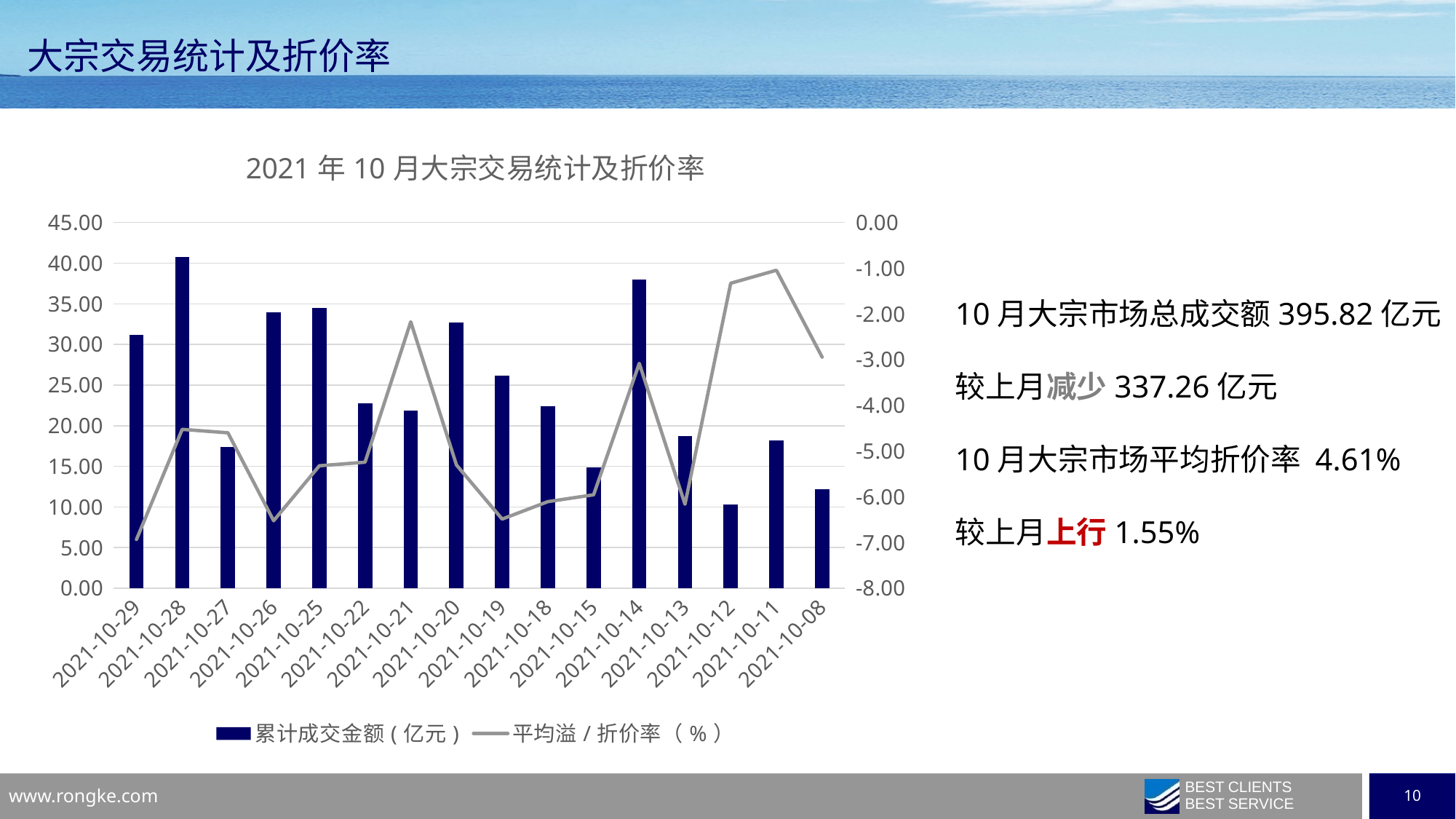
On which date does the 平均溢/折价率 (%) line reach its highest point (closest to 0.00)? 2021-10-11 Is the 累计成交金额 bar for 2021-10-28 greater or less than 35.00? greater How many dates are shown on the x axis of the chart? 16 Which has the larger 累计成交金额 bar, 2021-10-25 or 2021-10-22? 2021-10-25 What kind of chart is shown on the slide? A combined bar and line chart What is the title of the chart? 2021 年 10 月大宗交易统计及折价率 Which date has the lowest bar for 累计成交金额 (亿元)? 2021-10-12 How many series does the chart legend list? 2 Which date has the highest bar for 累计成交金额 (亿元)? 2021-10-28 Is the 累计成交金额 bar for 2021-10-27 greater or less than 20.00? less Is the 累计成交金额 bar for 2021-10-12 greater or less than 15.00? less On which date does the 平均溢/折价率 (%) line reach its lowest point? 2021-10-29